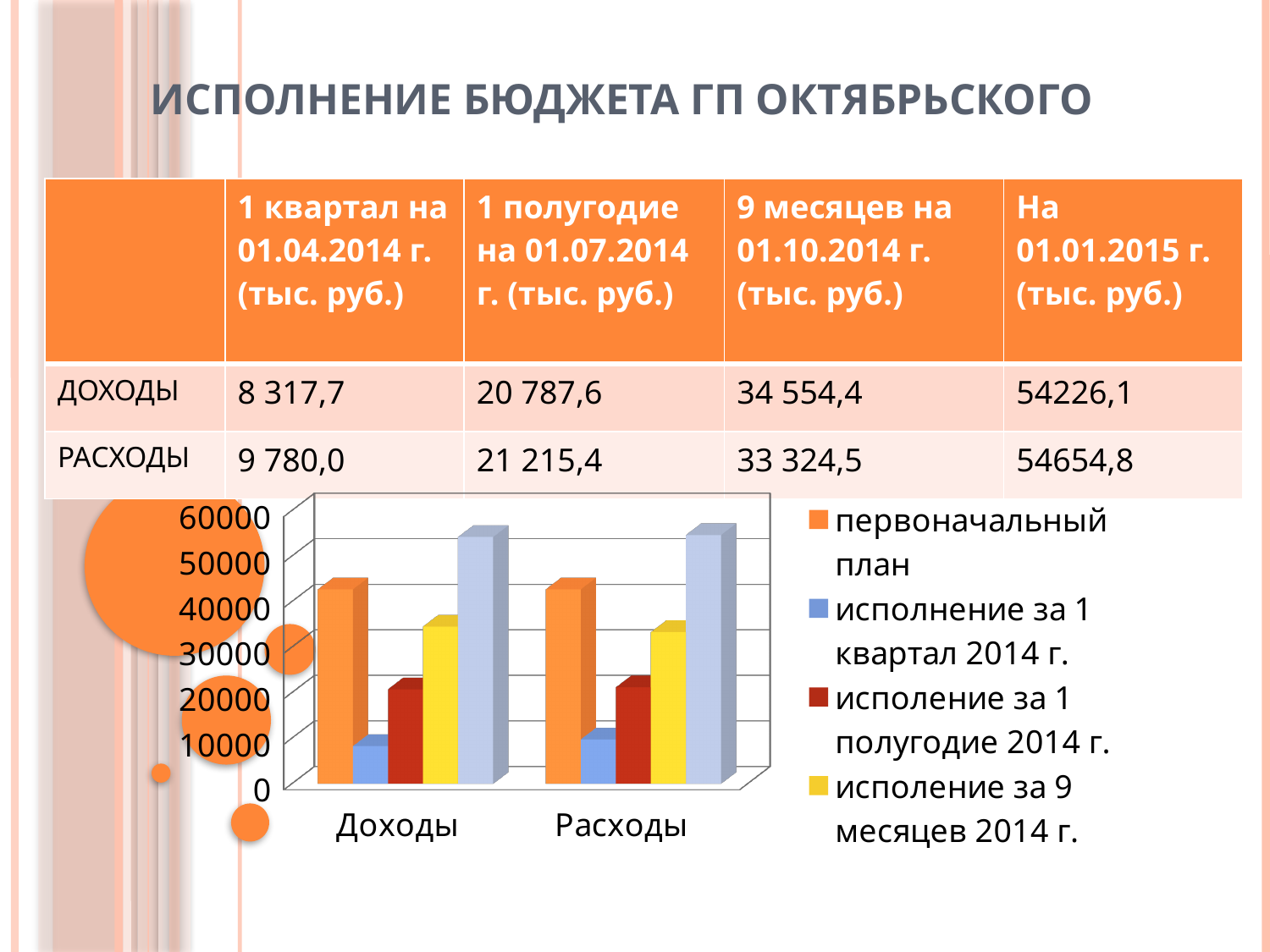
Is the value of 'исполение за 9 месяцев 2014 г.' for Доходы greater or less than 20000? greater Is the value of 'первоначальный план' for Доходы greater or less than 30000? greater Which legend entry is shown in orange? первоначальный план Within the Доходы category, do the execution values rise or fall from 1 квартал to 9 месяцев 2014? rise For Расходы, which is larger: the value for 'исполение за 9 месяцев 2014 г.' or for 'исполение за 1 полугодие 2014 г.'? исполение за 9 месяцев 2014 г. For Доходы, which is larger: the value for 'исполнение за 1 квартал 2014 г.' or for 'исполение за 1 полугодие 2014 г.'? исполение за 1 полугодие 2014 г. What are the two categories on the x axis of the chart? Доходы, Расходы How many series does the chart legend list? 4 How many categories are shown on the x axis of the chart? 2 Is the value of 'исполнение за 1 квартал 2014 г.' for Расходы greater or less than 20000? less What kind of chart is shown on the slide? bar chart